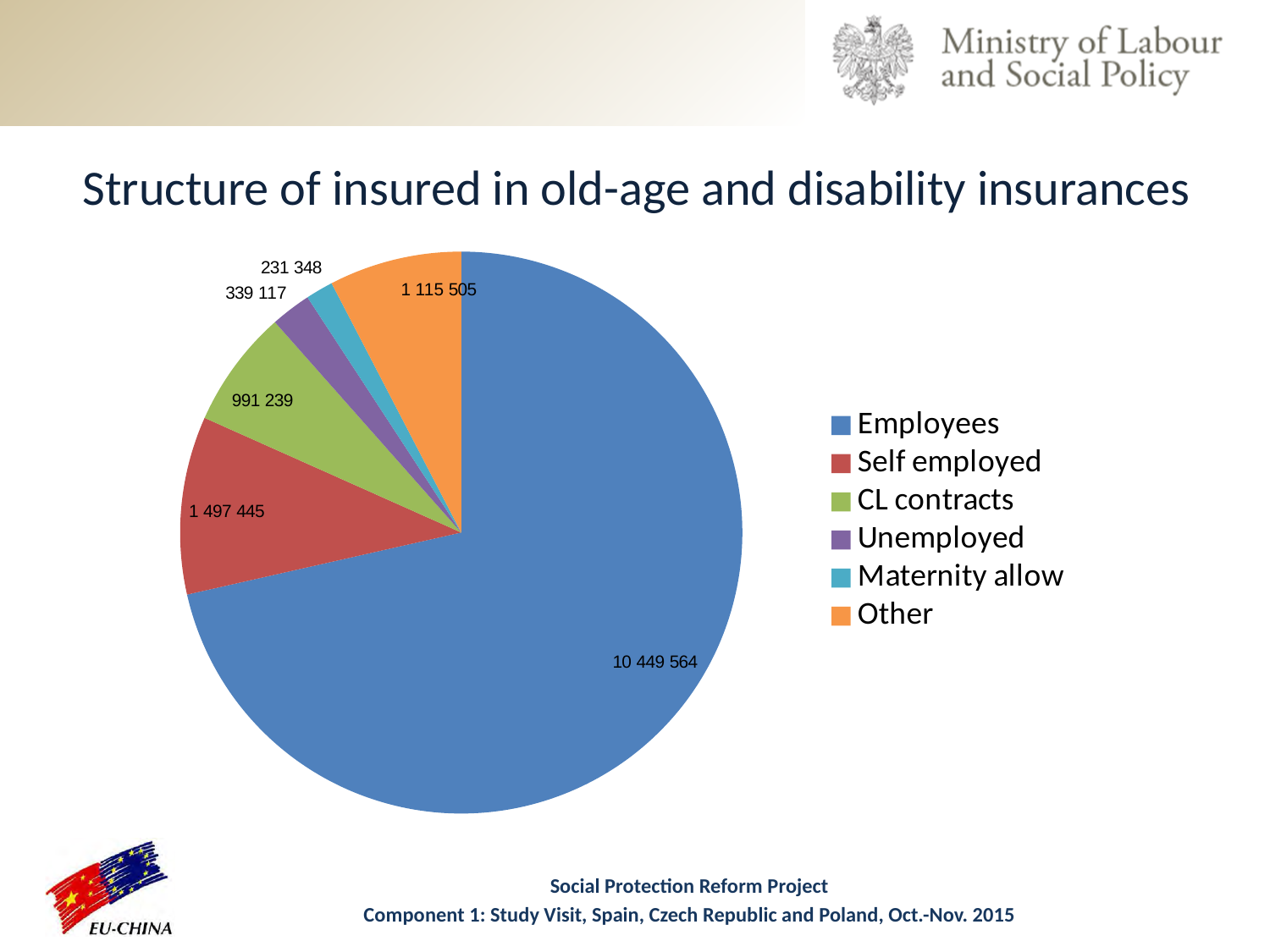
What is the value shown for CL contracts? 991 239 What is the value shown for Employees? 10 449 564 What is the difference between the values for Self employed and Other? 381 940 What is the value shown for Self employed? 1 497 445 Which category has the largest slice of the pie? Employees What is the difference between the values for Unemployed and Maternity allow? 107 769 What is the value shown for Maternity allow? 231 348 Which is larger, the value for CL contracts or the value for Other? Other How many categories does the legend list? 6 What is the value shown for Other? 1 115 505 Which category has the smallest slice of the pie? Maternity allow What type of chart is shown on the slide? Pie chart